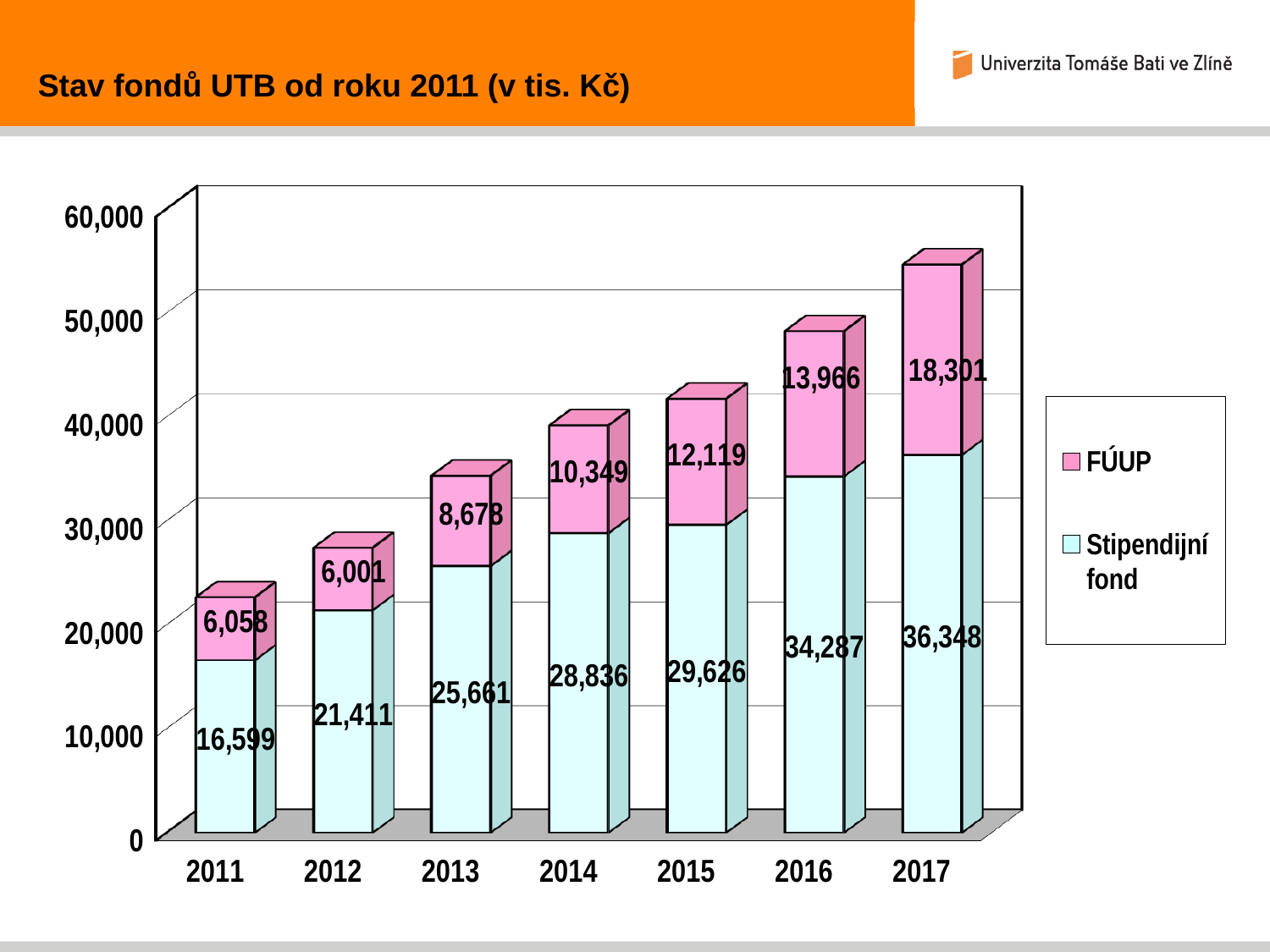
What is the value of FÚUP in 2013? 8,678 What is the value of Stipendijní fond in 2011? 16,599 What kind of chart is shown on the slide? Stacked bar chart In which year is the FÚUP value the lowest? 2012 What is the value of Stipendijní fond in 2017? 36,348 In which year is the Stipendijní fond value the highest? 2017 What is the total of the stacked bar for 2017? 54,649 What is the total of the stacked bar for 2011? 22,657 How many years are shown on the x axis? 7 What is the difference between the FÚUP values in 2017 and 2016? 4,335 How many series does the legend list? 2 Which is larger: the Stipendijní fond value in 2015 or in 2014? 2015